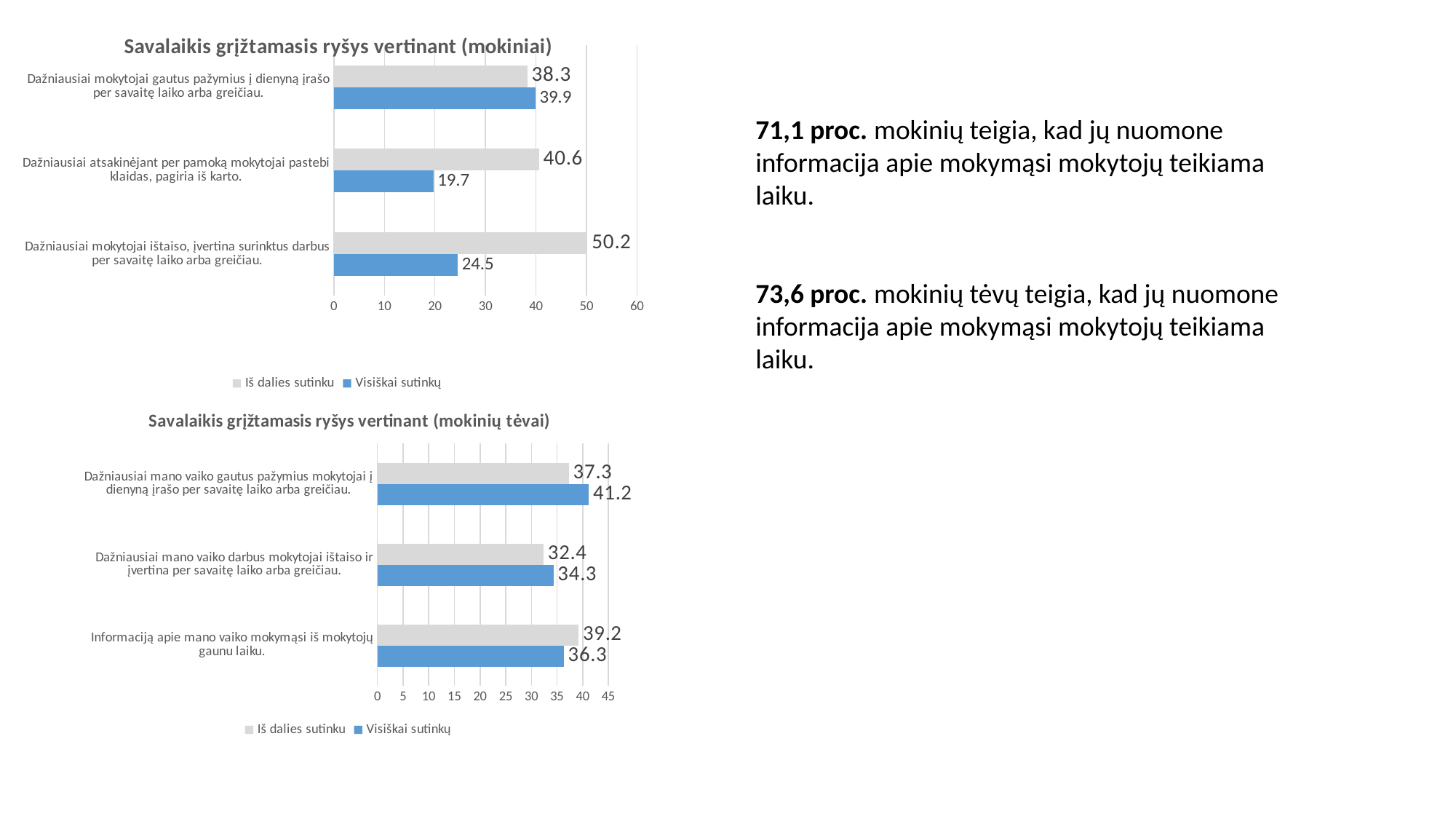
In the chart titled 'Savalaikis grįžtamasis ryšys vertinant (mokinių tėvai)', what is the 'Visiškai sutinkų' value for 'Dažniausiai mano vaiko gautus pažymius mokytojai į dienyną įrašo per savaitę laiko arba greičiau.'? 41.2 In the chart titled 'Savalaikis grįžtamasis ryšys vertinant (mokinių tėvai)', which is larger for 'Informaciją apie mano vaiko mokymąsi iš mokytojų gaunu laiku.': 'Iš dalies sutinku' or 'Visiškai sutinkų'? Iš dalies sutinku In the chart titled 'Savalaikis grįžtamasis ryšys vertinant (mokiniai)', how many series does the legend list? 2 In the chart titled 'Savalaikis grįžtamasis ryšys vertinant (mokiniai)', which category has the highest 'Iš dalies sutinku' value? Dažniausiai mokytojai ištaiso, įvertina surinktus darbus per savaitę laiko arba greičiau. In the chart titled 'Savalaikis grįžtamasis ryšys vertinant (mokiniai)', which category has the lowest 'Visiškai sutinkų' value? Dažniausiai atsakinėjant per pamoką mokytojai pastebi klaidas, pagiria iš karto. In the chart titled 'Savalaikis grįžtamasis ryšys vertinant (mokiniai)', what is the difference between the 'Iš dalies sutinku' and 'Visiškai sutinkų' values for 'Dažniausiai mokytojai ištaiso, įvertina surinktus darbus per savaitę laiko arba greičiau.'? 25.7 What kind of chart is 'Savalaikis grįžtamasis ryšys vertinant (mokinių tėvai)'? Bar chart In the chart titled 'Savalaikis grįžtamasis ryšys vertinant (mokiniai)', what is the 'Iš dalies sutinku' value for 'Dažniausiai mokytojai ištaiso, įvertina surinktus darbus per savaitę laiko arba greičiau.'? 50.2 In the chart titled 'Savalaikis grįžtamasis ryšys vertinant (mokinių tėvai)', which category has the lowest 'Iš dalies sutinku' value? Dažniausiai mano vaiko darbus mokytojai ištaiso ir įvertina per savaitę laiko arba greičiau. In the chart titled 'Savalaikis grįžtamasis ryšys vertinant (mokinių tėvai)', how many categories are shown? 3 In the chart titled 'Savalaikis grįžtamasis ryšys vertinant (mokiniai)', what is the 'Visiškai sutinkų' value for 'Dažniausiai atsakinėjant per pamoką mokytojai pastebi klaidas, pagiria iš karto.'? 19.7 In the chart titled 'Savalaikis grįžtamasis ryšys vertinant (mokinių tėvai)', what is the 'Iš dalies sutinku' value for 'Informaciją apie mano vaiko mokymąsi iš mokytojų gaunu laiku.'? 39.2